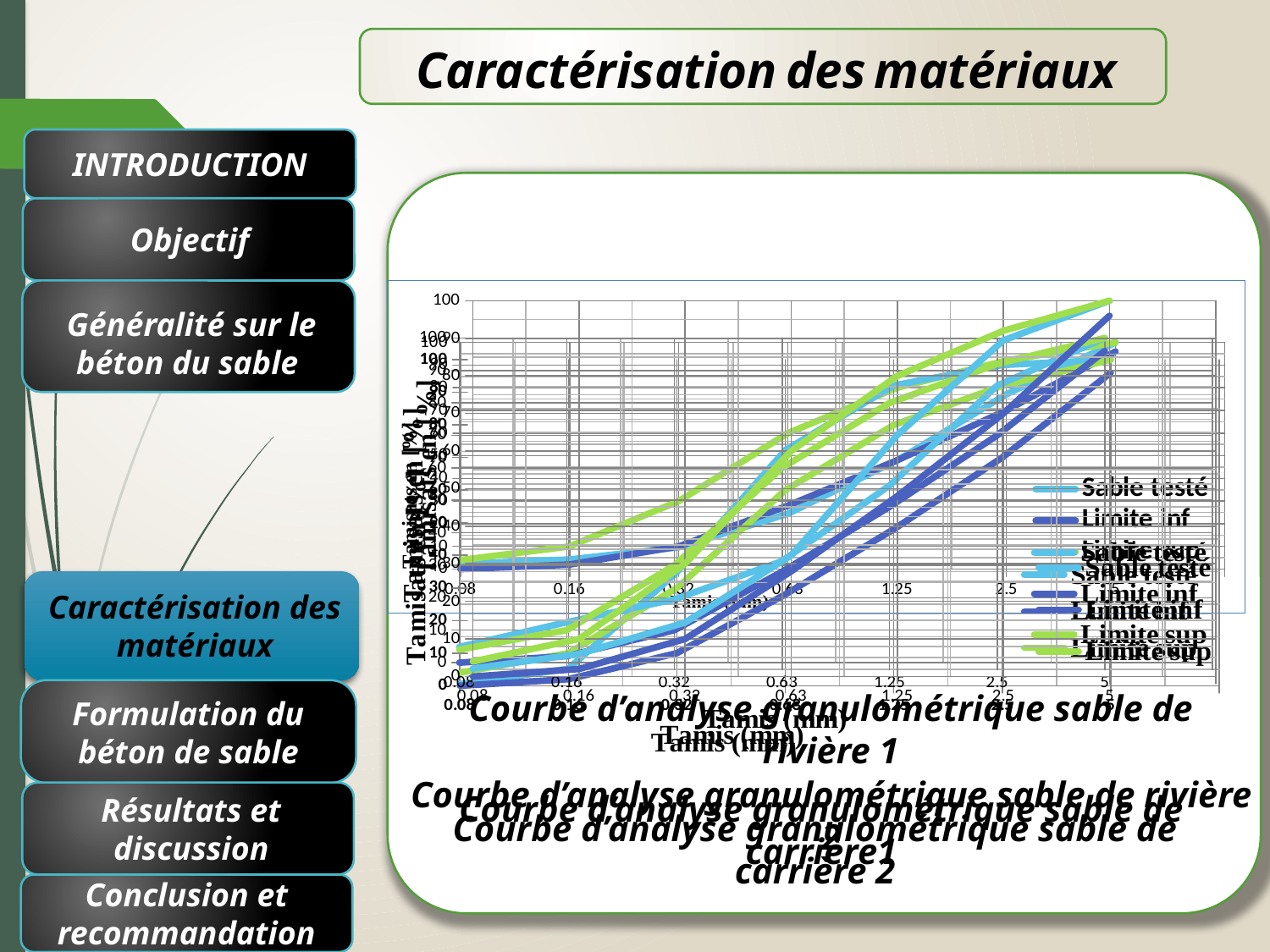
What is the smallest sieve size shown on the x axis of the granulometric analysis charts? 0.08 What is the maximum value shown on the y axis of the granulometric analysis charts? 100 Do the curves on the granulometric analysis charts rise or fall as the sieve size (Tamis) increases along the x axis? rise How many series does the legend list for each granulometric analysis chart? 3 What is the largest sieve size shown on the x axis of the granulometric analysis charts? 5 What kind of chart is used to show the granulometric analysis curves on this slide? line chart What are the three legend entries shown for the granulometric analysis charts? Sable testé, Limite inf, Limite sup What is the label of the x axis on the granulometric analysis charts? Tamis (mm) How many sieve sizes (tick values) are shown along the x axis of the granulometric analysis charts? 7